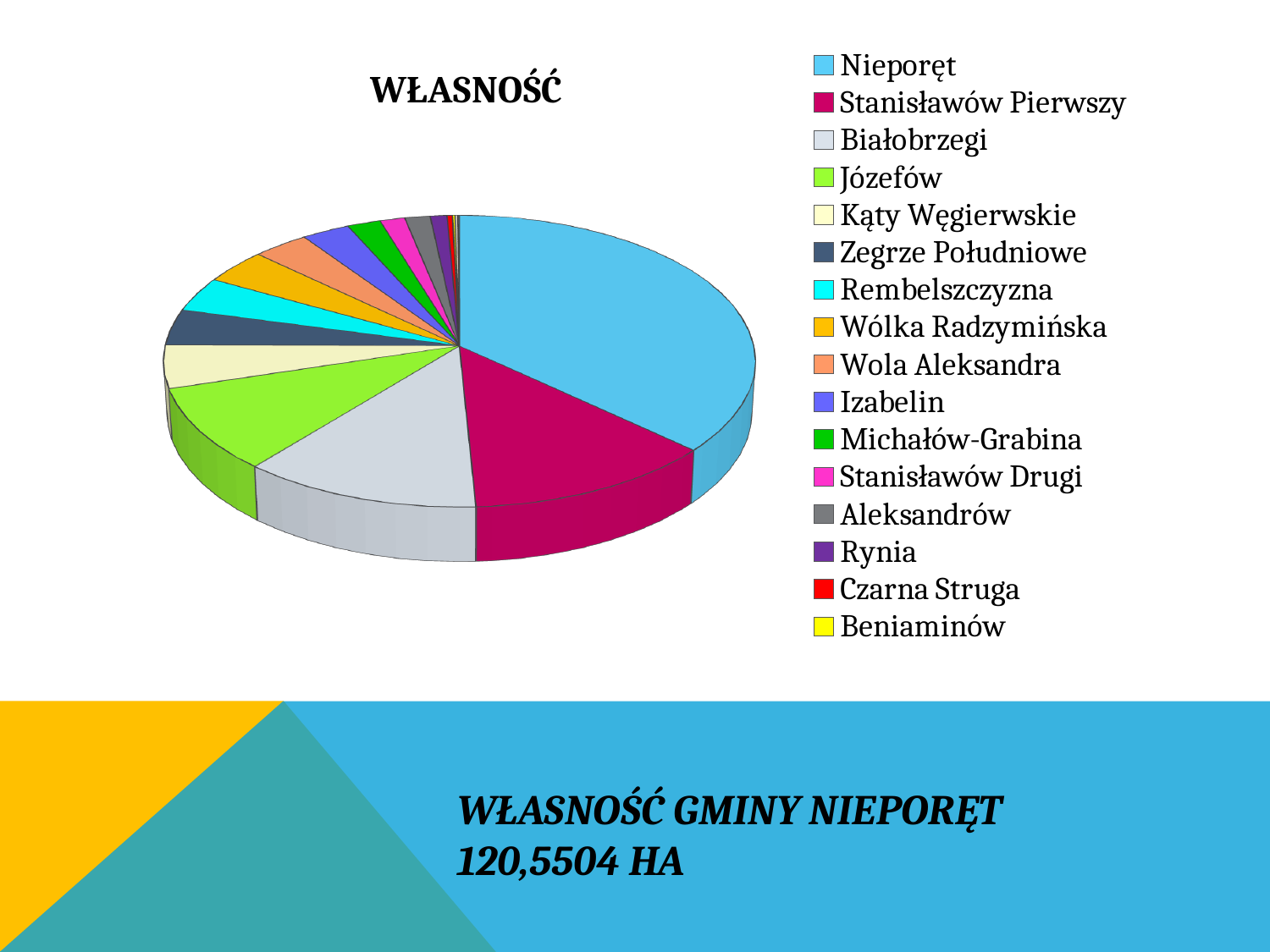
Which category is listed first in the legend? Nieporęt Which slice is larger, Białobrzegi or Wola Aleksandra? Białobrzegi What colour is the slice for Nieporęt? light blue What kind of chart is shown on the slide? pie chart Which slice is larger, Nieporęt or Józefów? Nieporęt Which category has the largest slice of the pie? Nieporęt Which slice is larger, Józefów or Kąty Węgierwskie? Józefów How many categories does the legend of the pie chart list? 16 What is the title of the chart? WŁASNOŚĆ